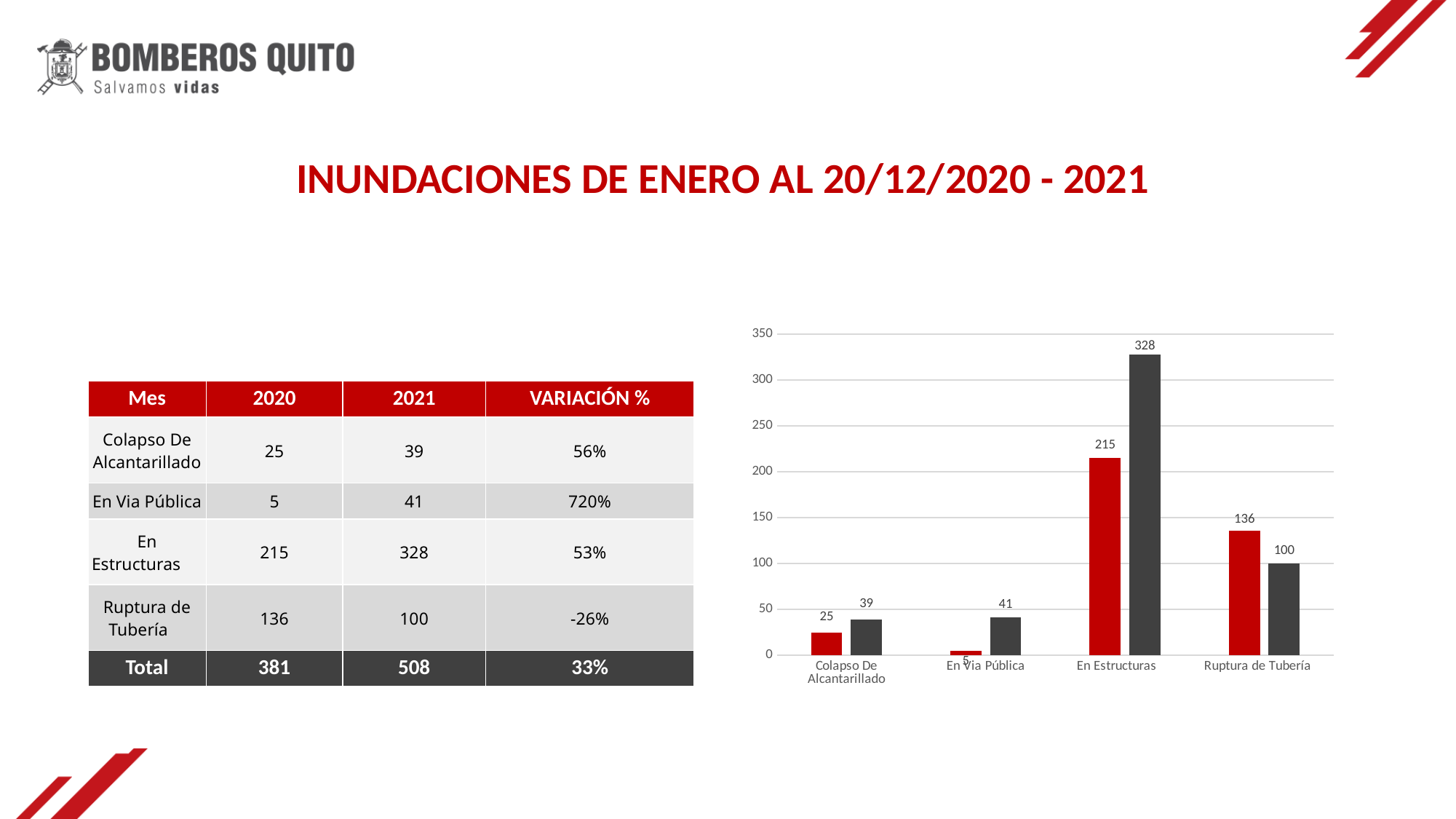
What is the difference between the dark grey bar and the red bar for En Via Pública? 36 For Ruptura de Tubería, which bar is larger, the red bar or the dark grey bar? the red bar What is the highest value shown on the chart's vertical axis? 350 What is the difference between the dark grey bar and the red bar for En Estructuras? 113 How many categories are shown on the x axis of the chart? 4 Which category has the highest dark grey bar? En Estructuras What type of chart is shown on the slide? bar chart What is the value of the dark grey bar for Ruptura de Tubería? 100 What is the value of the red bar for En Estructuras? 215 Is the value of the dark grey bar for En Estructuras greater or less than 300? greater What is the value of the dark grey bar for Colapso De Alcantarillado? 39 Which category has the lowest red bar? En Via Pública